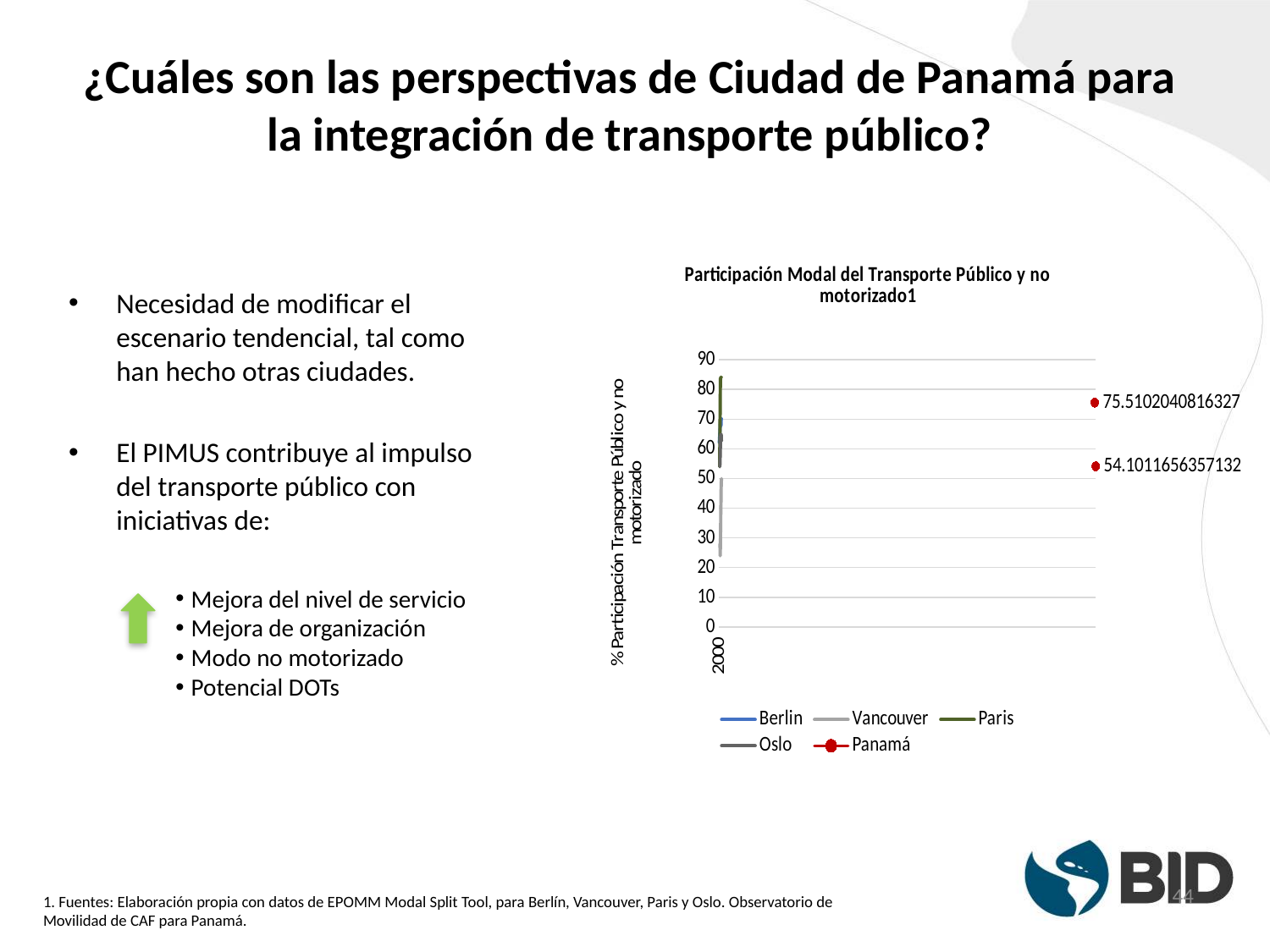
Is the lower labeled Panamá value greater or less than 60? less How many series does the chart legend list? 5 What is the highest value shown on the y axis? 90 What year label is shown on the x axis? 2000 Which series are listed in the chart legend? Berlin, Vancouver, Paris, Oslo, Panamá What kind of chart is shown on the slide? line chart What is the title of the chart? Participación Modal del Transporte Público y no motorizado1 Which of the two labeled Panamá values is larger, 75.5102040816327 or 54.1011656357132? 75.5102040816327 What is the lower data label shown for the Panamá series? 54.1011656357132 What is the higher data label shown for the Panamá series? 75.5102040816327 Which series in the legend is drawn in red with circular markers? Panamá Is the higher labeled Panamá value greater or less than 70? greater